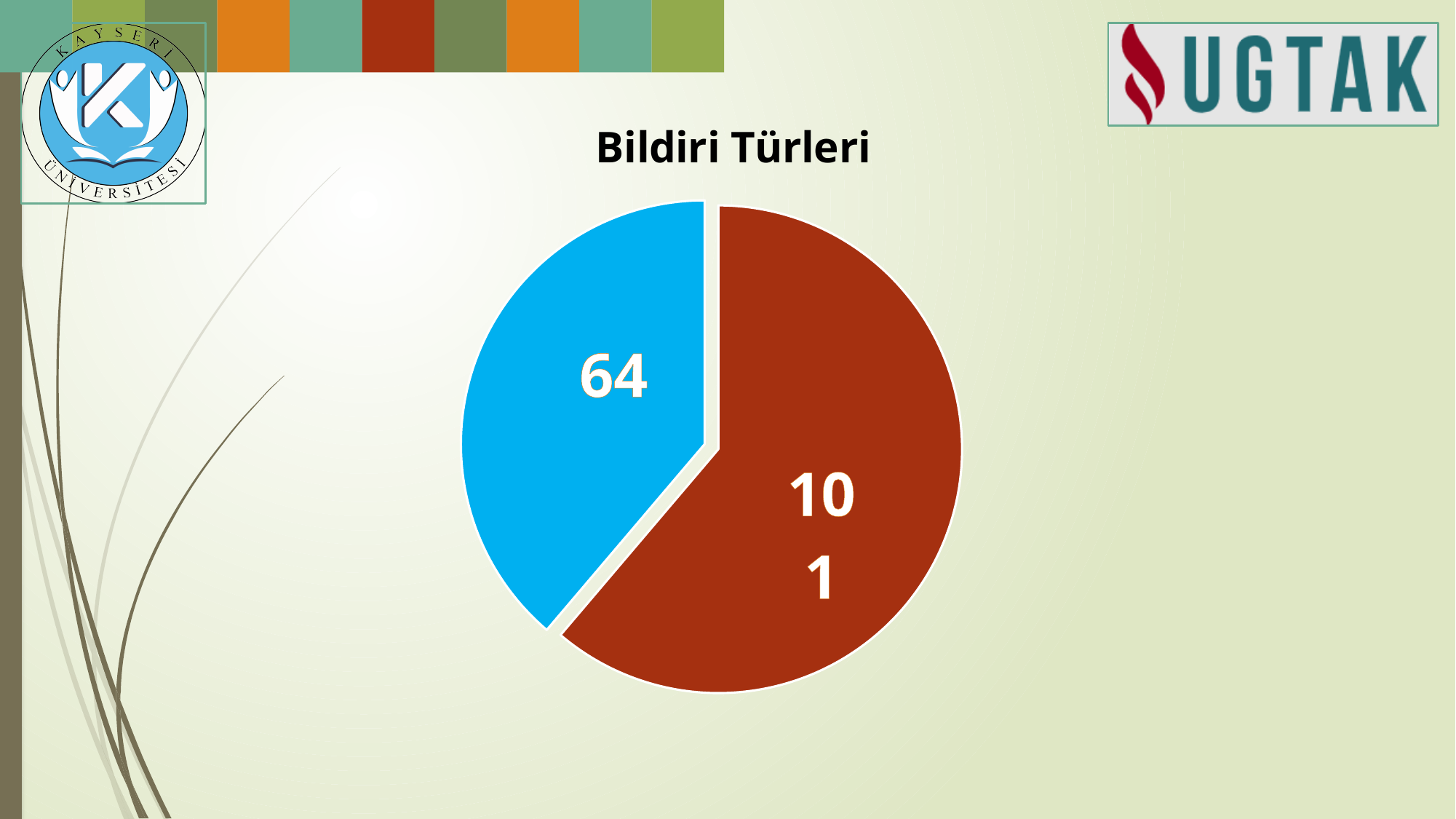
What is the title of the chart? Bildiri Türleri How many slices does the pie chart have? 2 What value is shown on the red slice of the pie chart? 101 Which slice of the pie chart has the smallest value? the blue slice (64) What two colours are used for the slices of the pie chart? blue and red What value is shown on the blue slice of the pie chart? 64 What kind of chart is shown on the slide? pie chart Which slice of the pie chart has the largest value? the red slice (101) Is the red slice or the blue slice larger? the red slice What is the total of the two values shown in the pie chart? 165 What is the difference between the red slice value and the blue slice value? 37